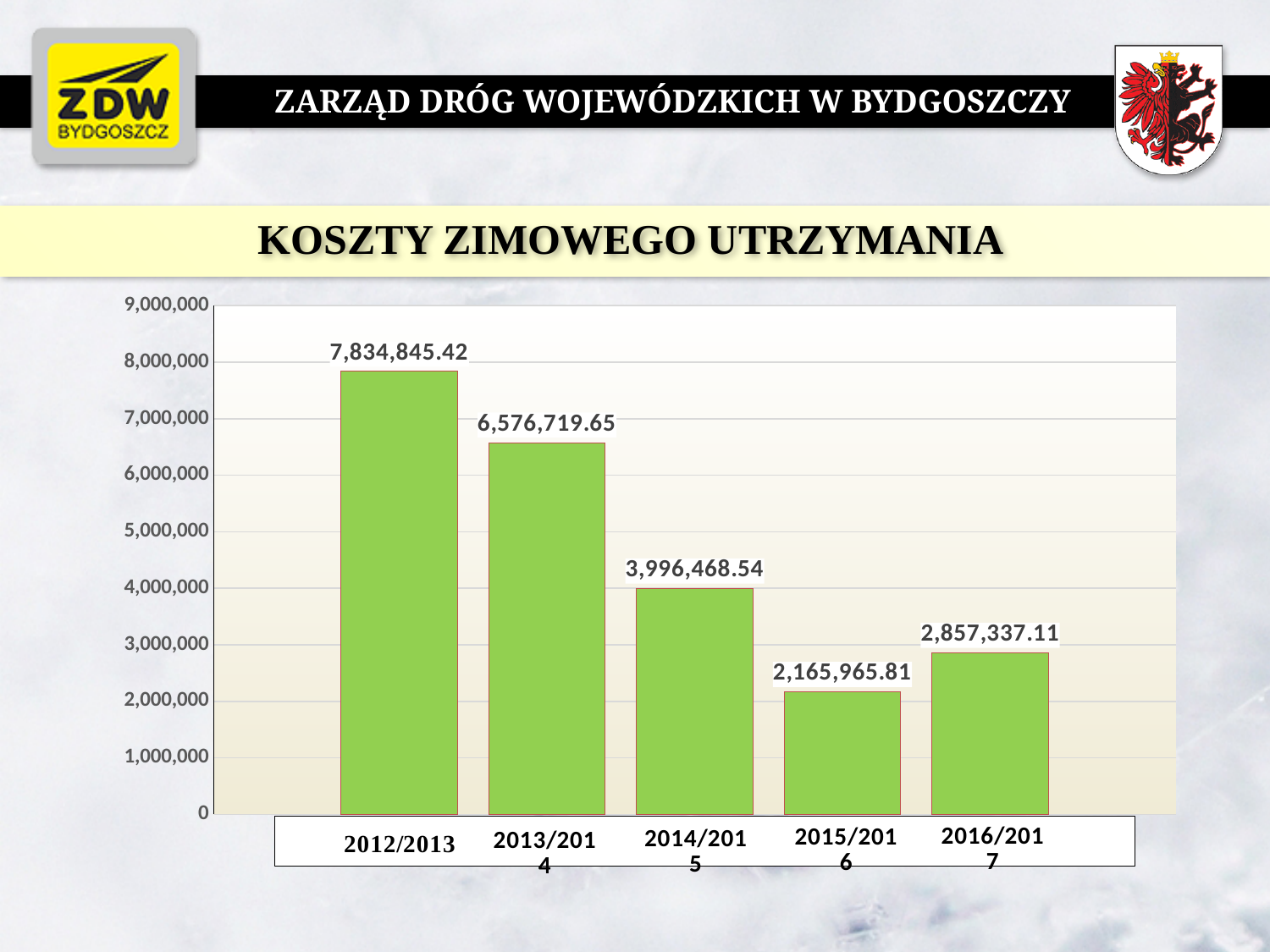
What kind of chart is shown on the slide? bar chart What is the value for 2014/2015? 3,996,468.54 Which season has the highest cost? 2012/2013 What is the value for 2012/2013? 7,834,845.42 Which season has the lowest cost? 2015/2016 What is the difference between the values for 2016/2017 and 2015/2016? 691,371.30 How many seasons are shown on the chart? 5 Which is larger, the value for 2015/2016 or the value for 2016/2017? 2016/2017 What is the value for 2016/2017? 2,857,337.11 Do the values rise or fall from 2012/2013 to 2015/2016? fall What is the difference between the values for 2012/2013 and 2013/2014? 1,258,125.77 Is the value for 2014/2015 greater or less than 4,000,000? less